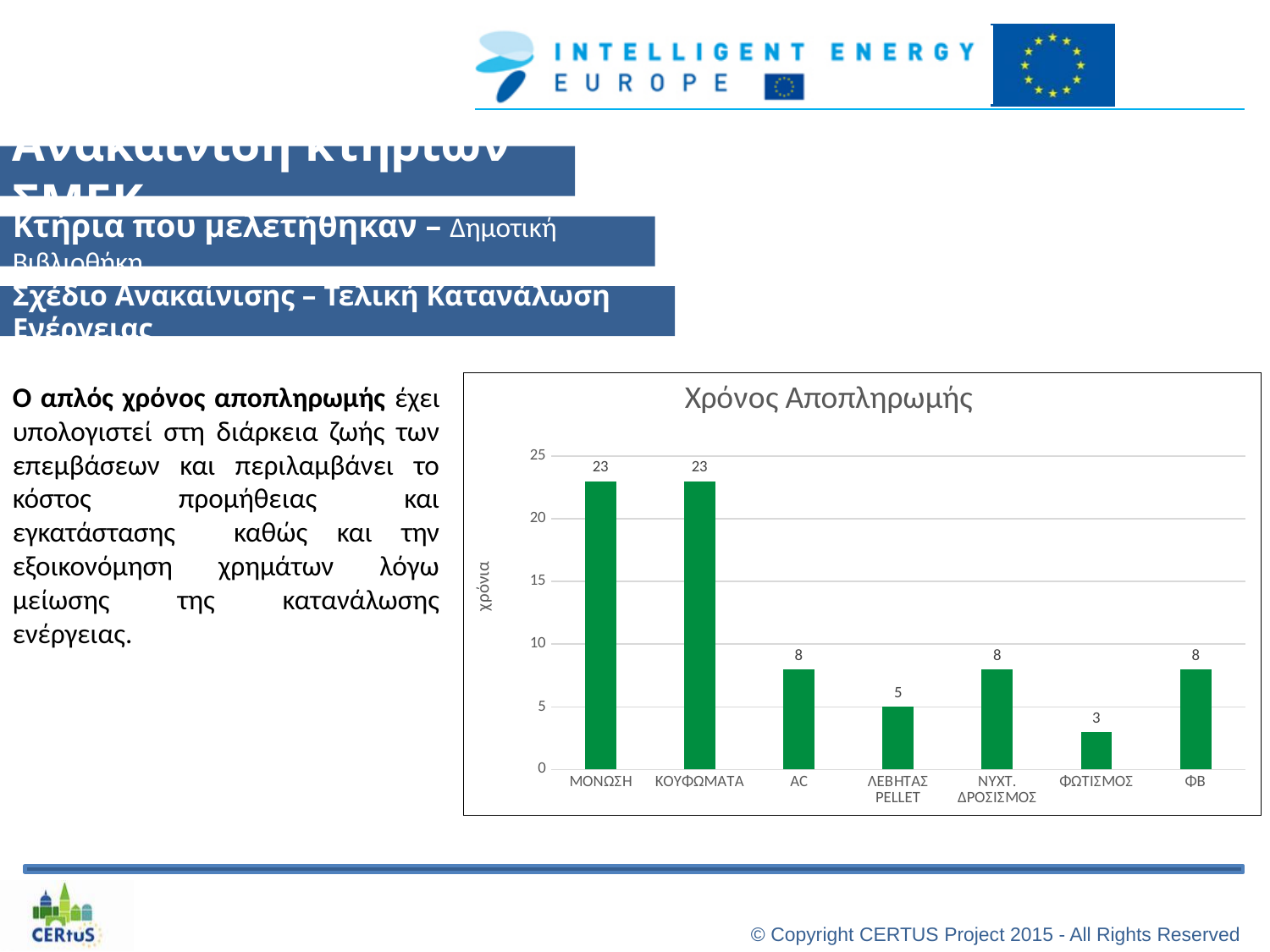
What is the title of the chart? Χρόνος Αποπληρωμής How many categories are shown on the x axis of the chart? 7 What is the value shown for ΦΩΤΙΣΜΟΣ? 3 Which is larger, the value for ΝΥΧΤ. ΔΡΟΣΙΣΜΟΣ or the value for ΛΕΒΗΤΑΣ PELLET? ΝΥΧΤ. ΔΡΟΣΙΣΜΟΣ What is the payback time value for ΜΟΝΩΣΗ in the chart? 23 What is the difference between the values for ΚΟΥΦΩΜΑΤΑ and AC? 15 Which category has the lowest payback time? ΦΩΤΙΣΜΟΣ What kind of chart is shown on the slide? bar chart Is the value for ΜΟΝΩΣΗ greater or less than 20? greater What is the difference between the values for ΛΕΒΗΤΑΣ PELLET and ΦΩΤΙΣΜΟΣ? 2 What is the value shown for ΦΒ? 8 What is the value shown for ΛΕΒΗΤΑΣ PELLET? 5